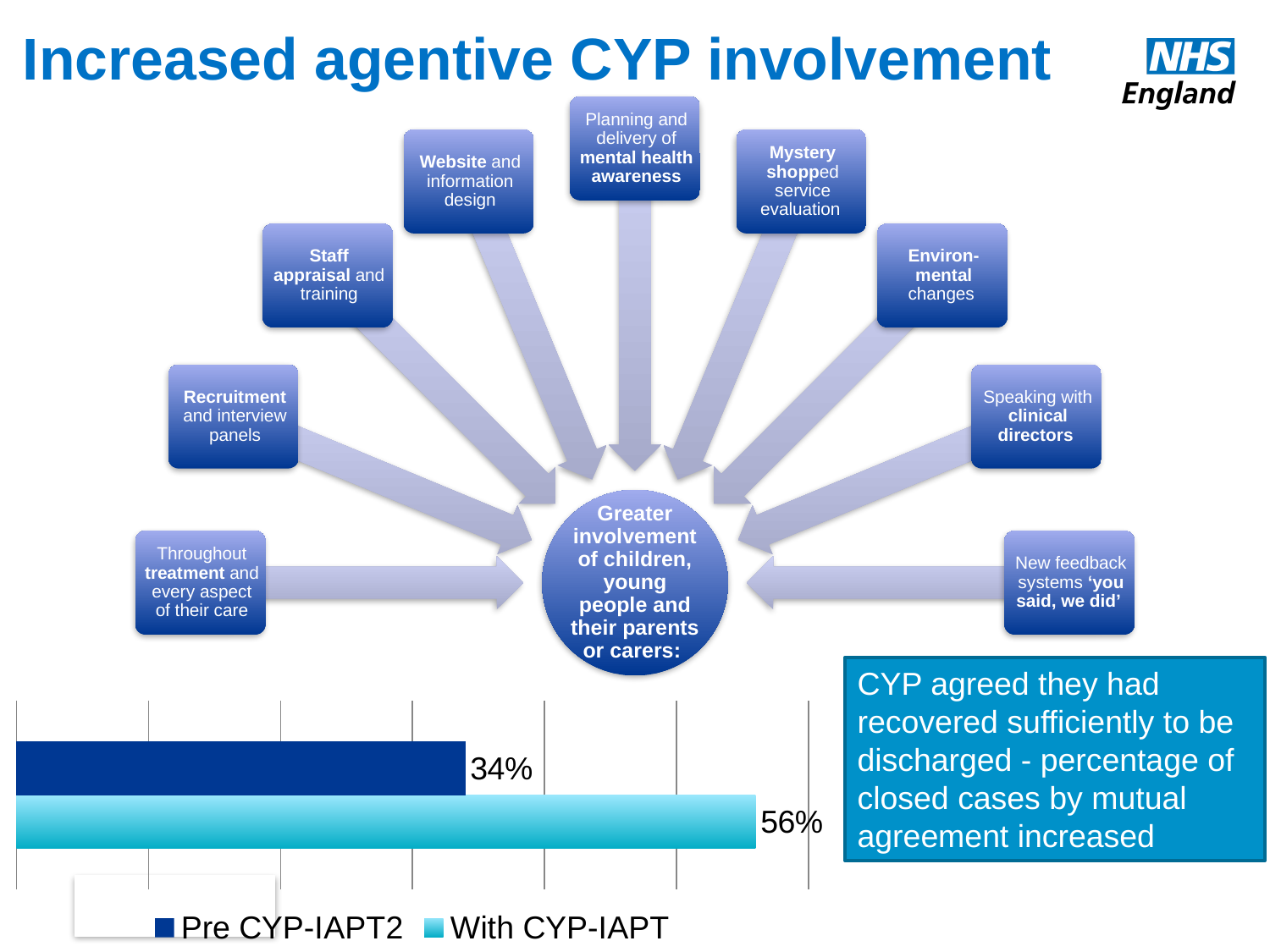
What value is shown for the Pre CYP-IAPT2 bar in the bar chart? 34% Which series has the higher value in the bar chart, Pre CYP-IAPT2 or With CYP-IAPT? With CYP-IAPT Which series has the highest value in the bar chart? With CYP-IAPT How many bars are plotted in the chart at the bottom of the slide? 2 Which series has the lowest value in the bar chart? Pre CYP-IAPT2 What kind of chart is shown at the bottom of the slide? Bar chart Which legend entry in the bar chart is shown in dark blue? Pre CYP-IAPT2 What value is shown for the With CYP-IAPT bar in the bar chart? 56% What is the difference in percentage points between the With CYP-IAPT and Pre CYP-IAPT2 values in the bar chart? 22 What are the two legend entries of the bar chart? Pre CYP-IAPT2 and With CYP-IAPT How many series does the legend of the bar chart list? 2